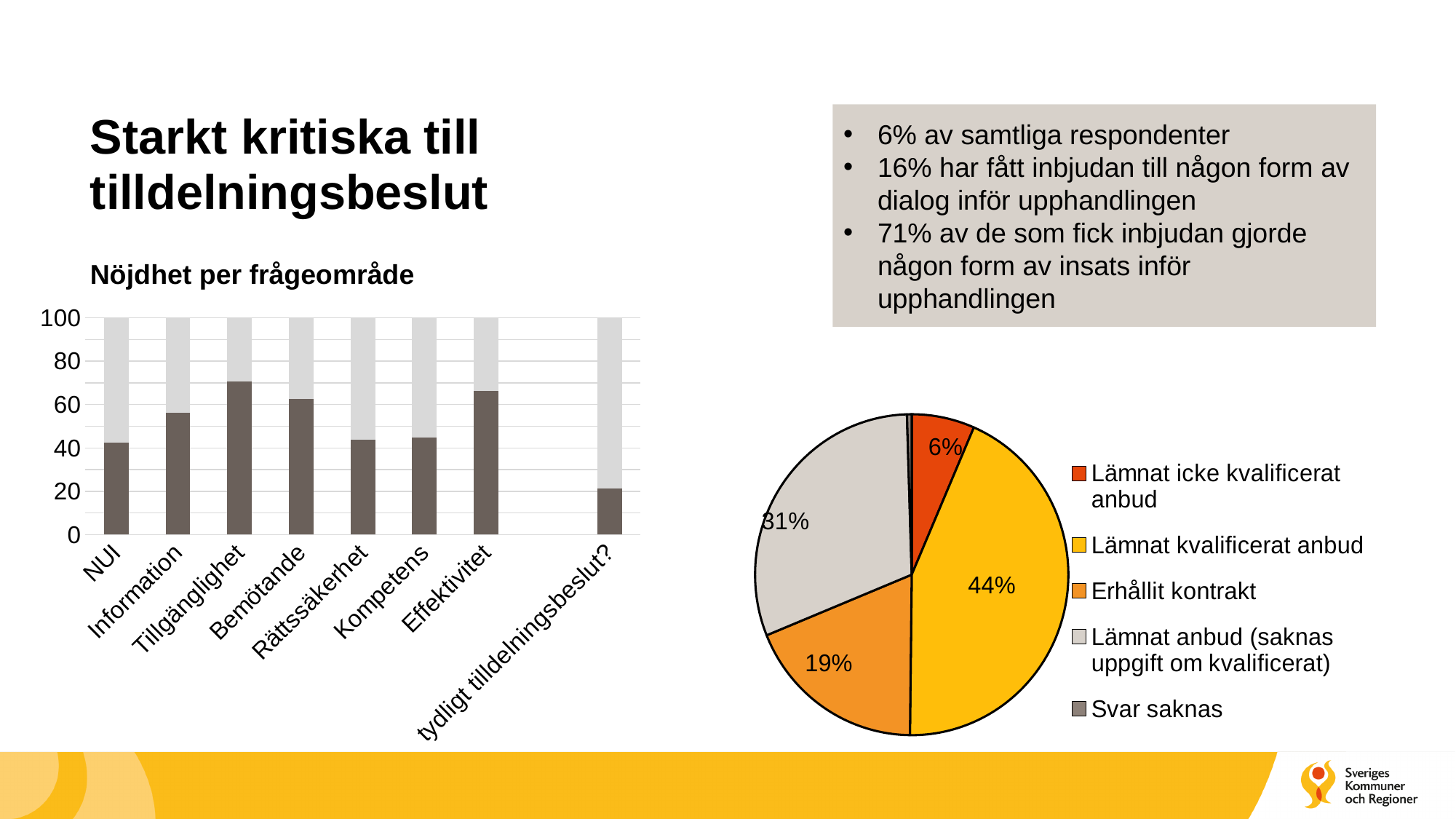
In the pie chart on the right, what share is 'Erhållit kontrakt'? 19% In the 'Nöjdhet per frågeområde' chart, is the value for Tillgänglighet greater or less than 60? greater In the 'Nöjdhet per frågeområde' chart, which category has the lowest bar? tydligt tilldelningsbeslut? In the 'Nöjdhet per frågeområde' chart, which category has the highest bar? Tillgänglighet In the pie chart on the right, what share is 'Lämnat kvalificerat anbud'? 44% What kind of chart is 'Nöjdhet per frågeområde'? bar chart In the 'Nöjdhet per frågeområde' chart, is the value for tydligt tilldelningsbeslut? greater or less than 40? less How many entries does the legend of the pie chart on the right list? 5 In the pie chart on the right, what is the difference between the shares for 'Lämnat kvalificerat anbud' and 'Lämnat anbud (saknas uppgift om kvalificerat)'? 13% In the 'Nöjdhet per frågeområde' chart, which is larger, the value for Effektivitet or the value for Information? Effektivitet In the 'Nöjdhet per frågeområde' chart, how many categories are shown on the x axis? 8 In the 'Nöjdhet per frågeområde' chart, is the value for NUI greater or less than 60? less